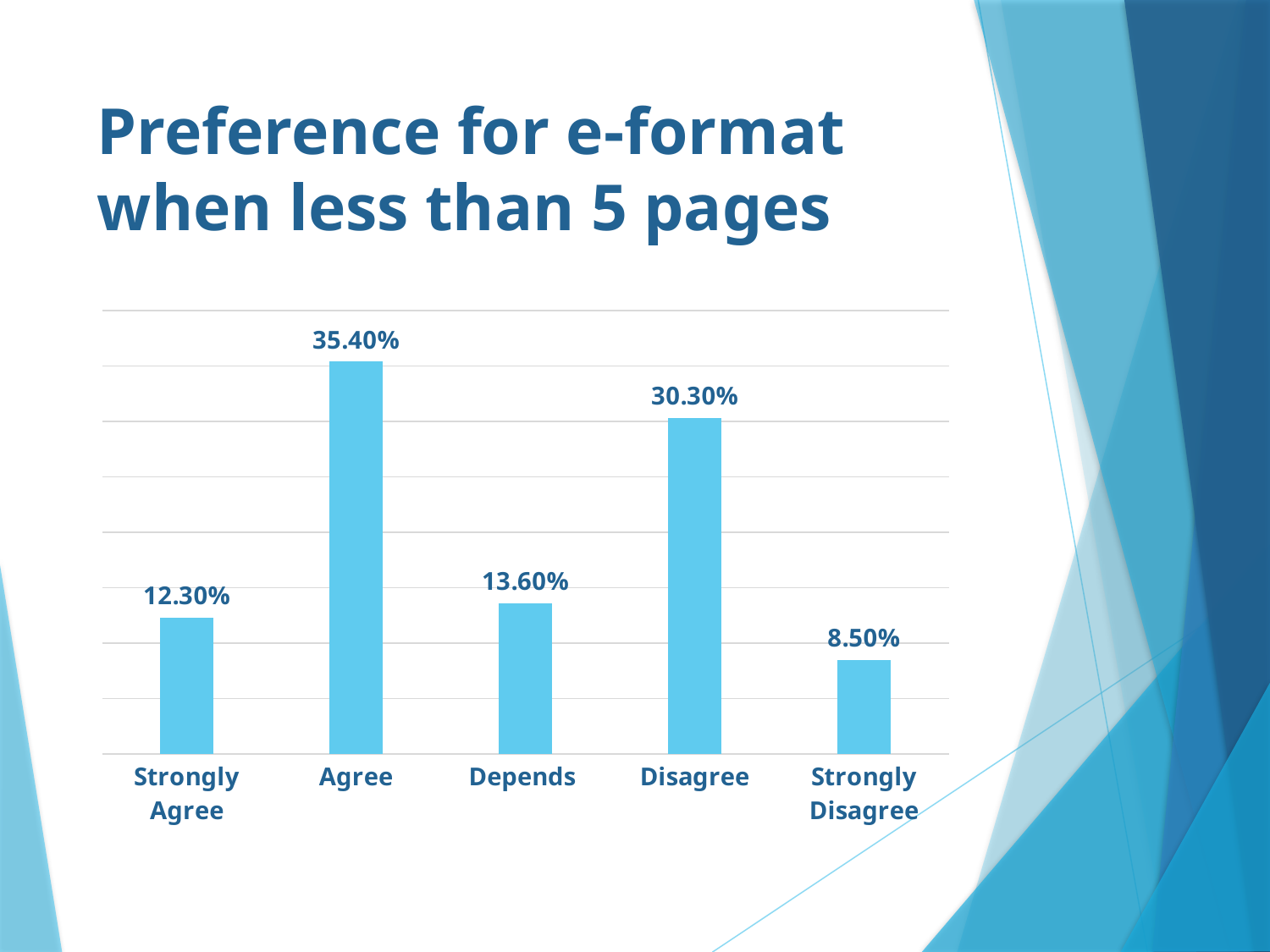
What is the value for Depends? 13.60% Which is larger, the value for Strongly Agree or the value for Depends? Depends What is the value for Strongly Agree? 12.30% What is the title of the slide containing the chart? Preference for e-format when less than 5 pages What kind of chart is shown on the slide? Bar chart What is the value for Strongly Disagree? 8.50% What is the value for Agree? 35.40% What is the difference between the values for Agree and Disagree? 5.10% Which category has the lowest value? Strongly Disagree How many categories are shown on the x axis? 5 What is the difference between the values for Disagree and Strongly Disagree? 21.80% Which category has the highest value? Agree